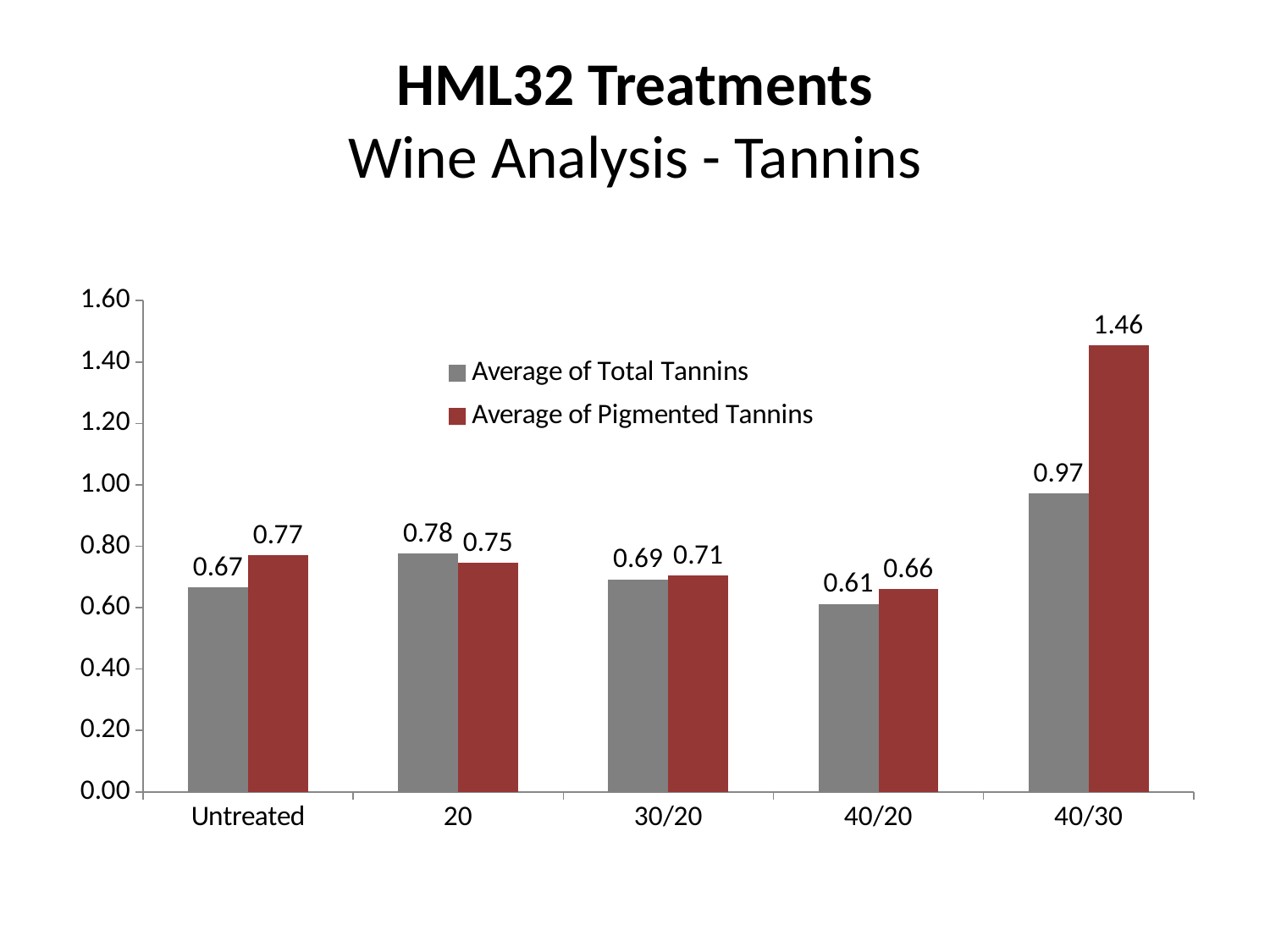
What kind of chart is shown on the slide? Bar chart What is the Average of Total Tannins for the Untreated category? 0.67 Which category has the highest Average of Pigmented Tannins? 40/30 For the 20 treatment, which is larger: Average of Total Tannins or Average of Pigmented Tannins? Average of Total Tannins What is the difference between the Average of Pigmented Tannins and the Average of Total Tannins for the 40/30 treatment? 0.49 Which category has the lowest Average of Total Tannins? 40/20 How many treatment categories are shown on the x axis? 5 What colour are the bars for Average of Pigmented Tannins? Dark red Is the Average of Pigmented Tannins for 40/30 greater or less than 1.20? greater What is the Average of Total Tannins for the 40/20 treatment? 0.61 How many series does the legend list? 2 What is the Average of Pigmented Tannins for the 40/30 treatment? 1.46